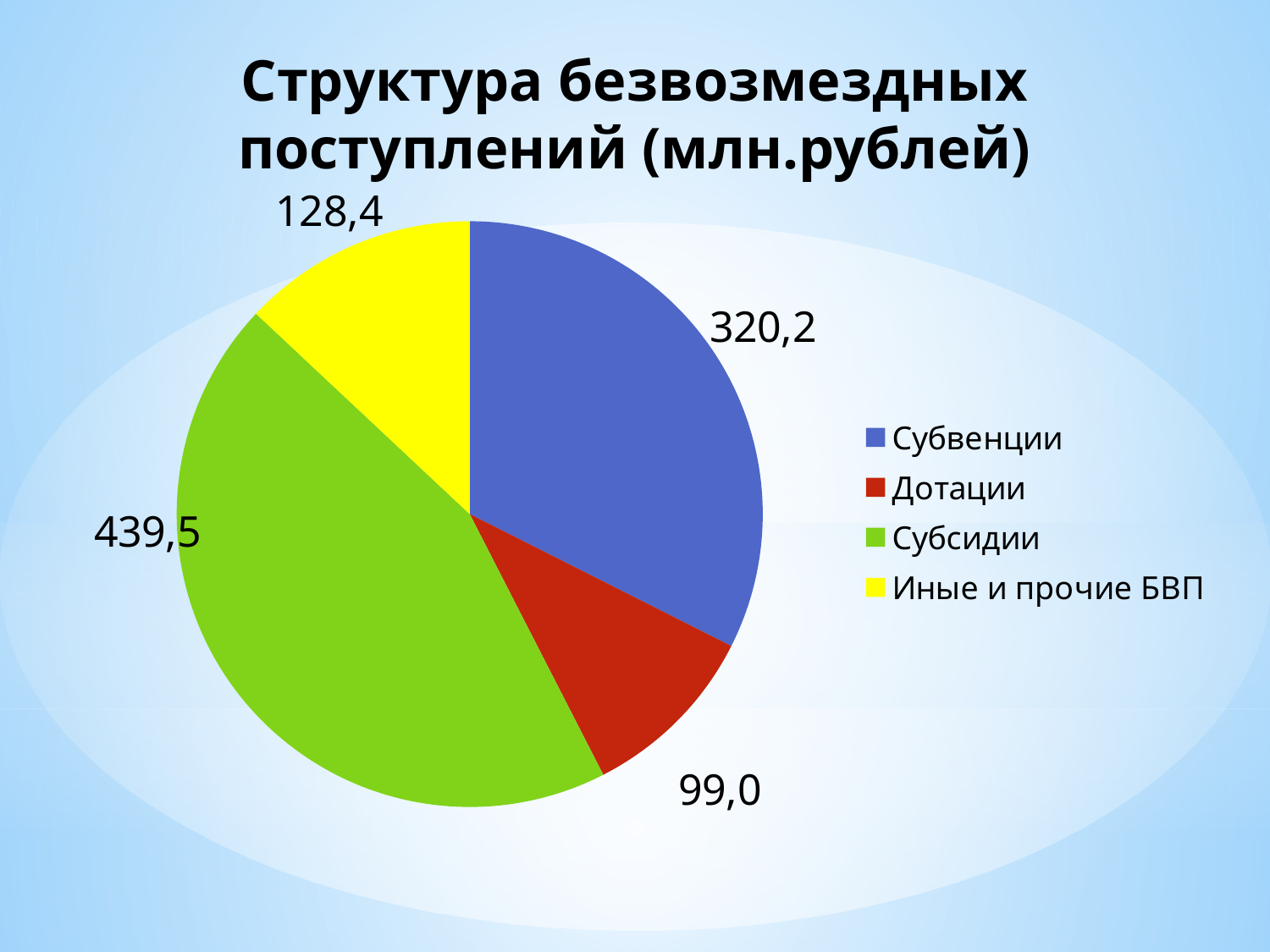
Which category has the largest slice of the pie? Субсидии What is the value for Субвенции? 320,2 What is the difference between the values for Субсидии and Субвенции? 119,3 What is the value for Дотации? 99,0 What is the value for Субсидии? 439,5 Which is larger, the value for Субвенции or the value for Иные и прочие БВП? Субвенции What colour is the slice for Субсидии? Green Which category has the smallest slice of the pie? Дотации What is the difference between the values for Иные и прочие БВП and Дотации? 29,4 What is the value for Иные и прочие БВП? 128,4 How many categories does the pie chart show? 4 What kind of chart is shown on the slide? Pie chart